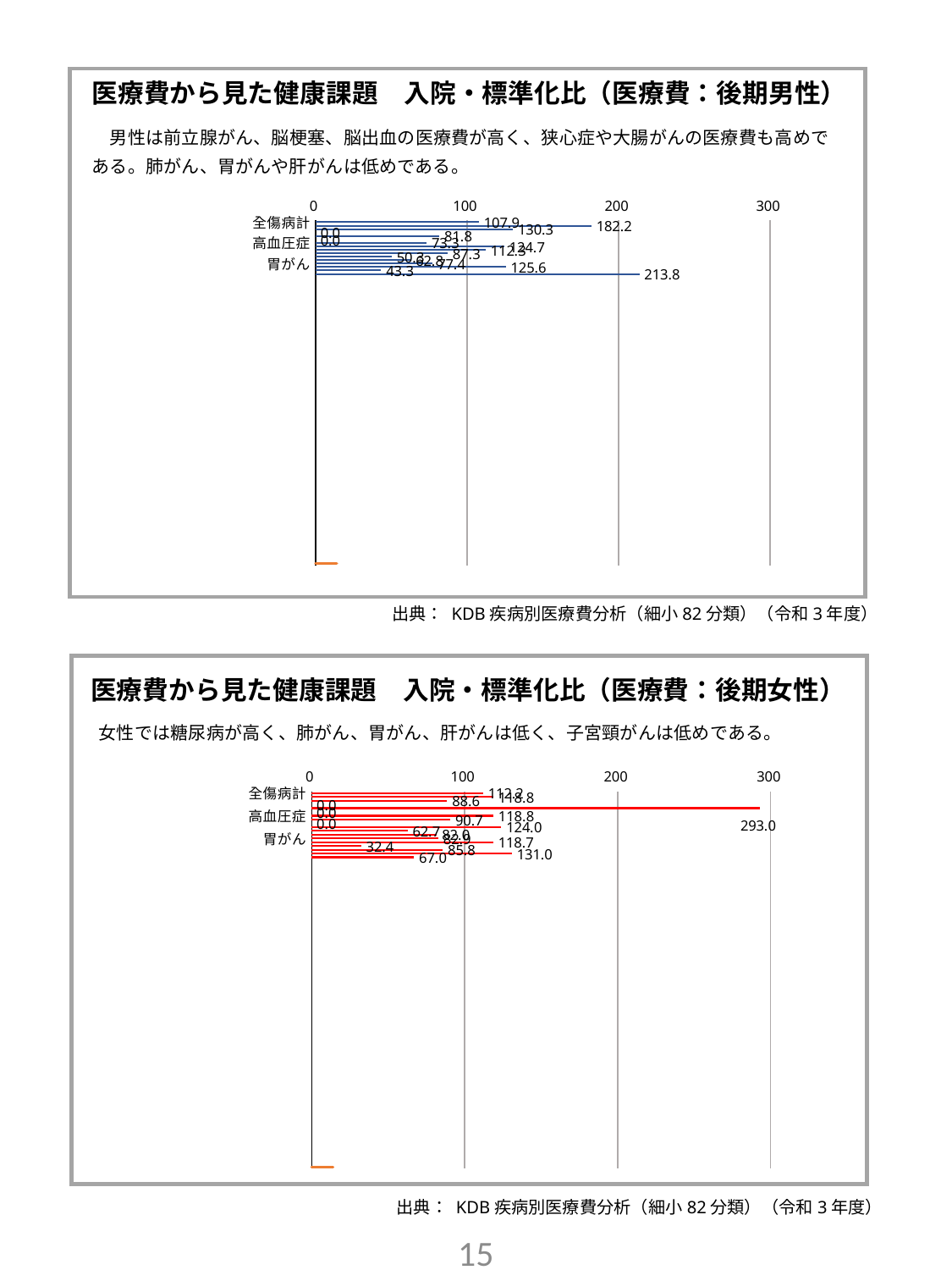
Which chart has the larger maximum bar value, the top chart (後期男性) or the bottom chart (後期女性)? the bottom chart (後期女性) Is the longest bar in the top chart (後期男性) greater or less than 300? less What type of chart is used on the top chart (医療費：後期男性)? bar chart In the bottom chart (後期女性), what is the largest value printed on any bar? 293.0 What is the highest tick value shown on the x axis of the top chart? 300 What is the difference between the largest value in the bottom chart (293.0) and the largest value in the top chart (213.8)? 79.2 In the top chart (後期男性), what is the smallest value printed on any bar? 0.0 In the top chart (後期男性), what is the largest value printed on any bar? 213.8 In the top chart (後期男性), what is the value for 全傷病計? 107.9 What is the title of the bottom chart? 医療費から見た健康課題 入院・標準化比（医療費：後期女性） Is the longest bar in the bottom chart (後期女性) greater or less than 200? greater